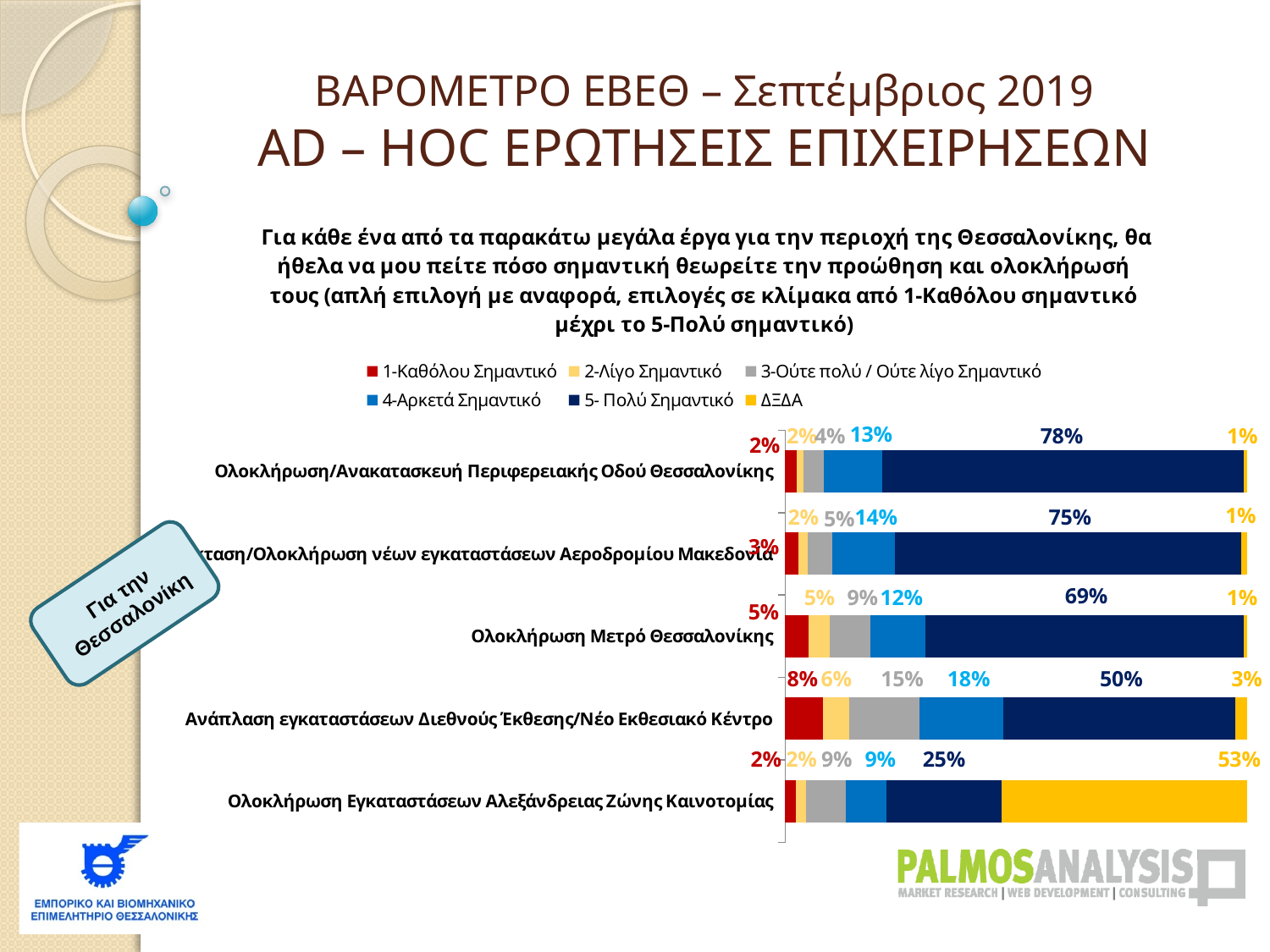
How many projects (categories) are shown in the chart? 5 What is the combined total of 4-Αρκετά Σημαντικό and 5-Πολύ Σημαντικό for Ανάπλαση εγκαταστάσεων Διεθνούς Έκθεσης/Νέο Εκθεσιακό Κέντρο? 68% What is the ΔΞΔΑ value for Ολοκλήρωση Εγκαταστάσεων Αλεξάνδρειας Ζώνης Καινοτομίας? 53% Which project has the highest 5-Πολύ Σημαντικό percentage? Ολοκλήρωση/Ανακατασκευή Περιφερειακής Οδού Θεσσαλονίκης How many series does the legend list? 6 What is the 1-Καθόλου Σημαντικό value for Ολοκλήρωση/Ανακατασκευή Περιφερειακής Οδού Θεσσαλονίκης? 2% What is the difference between the 5-Πολύ Σημαντικό values for Ολοκλήρωση/Ανακατασκευή Περιφερειακής Οδού Θεσσαλονίκης and Ολοκλήρωση Μετρό Θεσσαλονίκης? 9% Which has a larger 3-Ούτε πολύ / Ούτε λίγο Σημαντικό value: Ολοκλήρωση Μετρό Θεσσαλονίκης or Ανάπλαση εγκαταστάσεων Διεθνούς Έκθεσης/Νέο Εκθεσιακό Κέντρο? Ανάπλαση εγκαταστάσεων Διεθνούς Έκθεσης/Νέο Εκθεσιακό Κέντρο What is the 4-Αρκετά Σημαντικό value for Ανάπλαση εγκαταστάσεων Διεθνούς Έκθεσης/Νέο Εκθεσιακό Κέντρο? 18% What kind of chart is shown on the slide? Stacked bar chart Which project has the lowest 5-Πολύ Σημαντικό percentage? Ολοκλήρωση Εγκαταστάσεων Αλεξάνδρειας Ζώνης Καινοτομίας What percentage of respondents rated Ολοκλήρωση Μετρό Θεσσαλονίκης as 5-Πολύ Σημαντικό? 69%